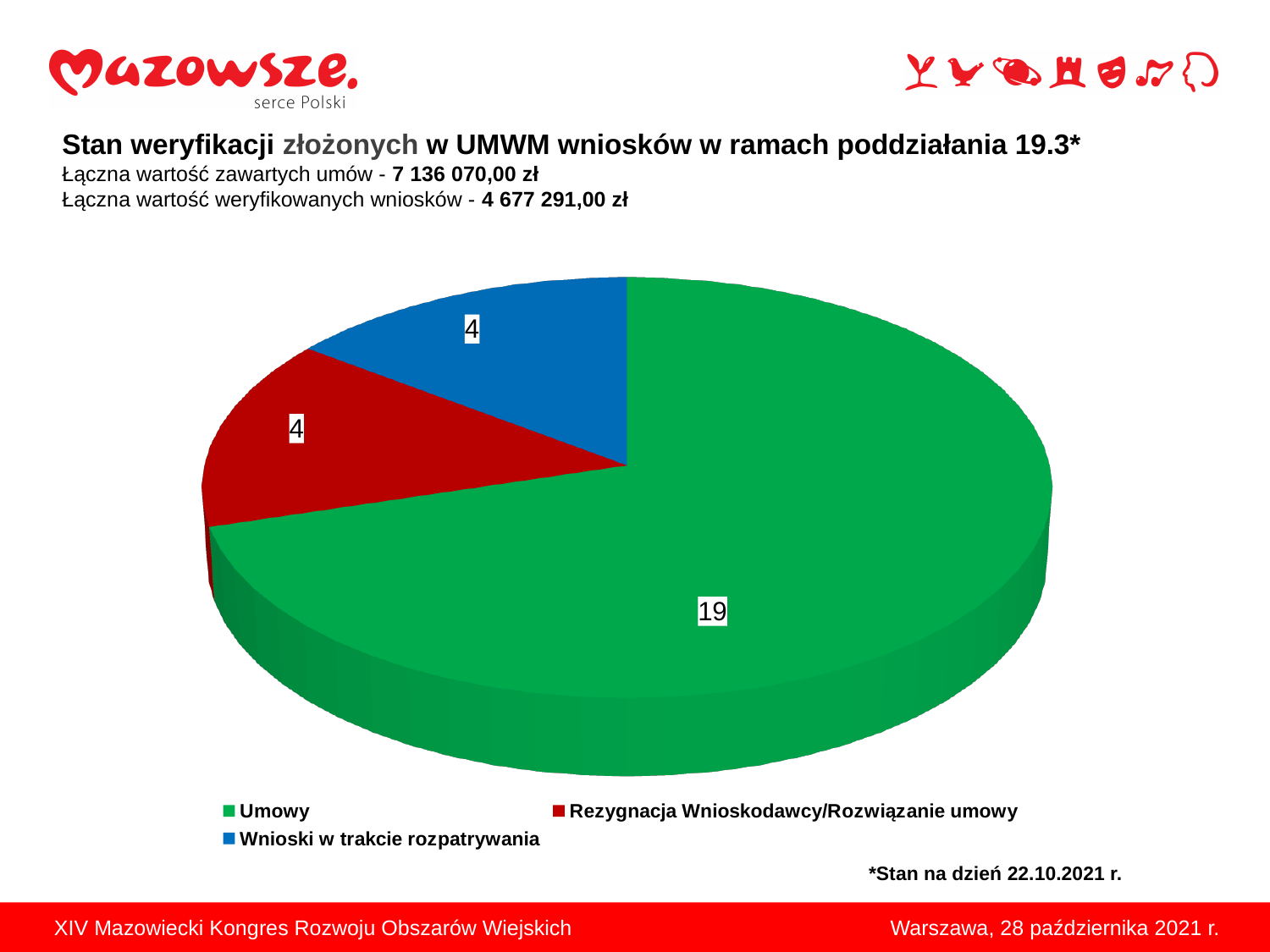
Which category has the largest slice of the pie? Umowy What colour is the Umowy slice? green What is the difference between the value for Umowy and the value for Rezygnacja Wnioskodawcy/Rozwiązanie umowy? 15 What is the value shown for the Umowy slice? 19 How many entries does the legend list? 3 What colour is the Wnioski w trakcie rozpatrywania slice? blue What is the total of all the values shown on the pie chart? 27 What is the value shown for the Rezygnacja Wnioskodawcy/Rozwiązanie umowy slice? 4 What kind of chart is shown on the slide? pie chart Which is larger, the value for Umowy or the value for Wnioski w trakcie rozpatrywania? Umowy What is the value shown for the Wnioski w trakcie rozpatrywania slice? 4 How many slices does the pie chart have? 3